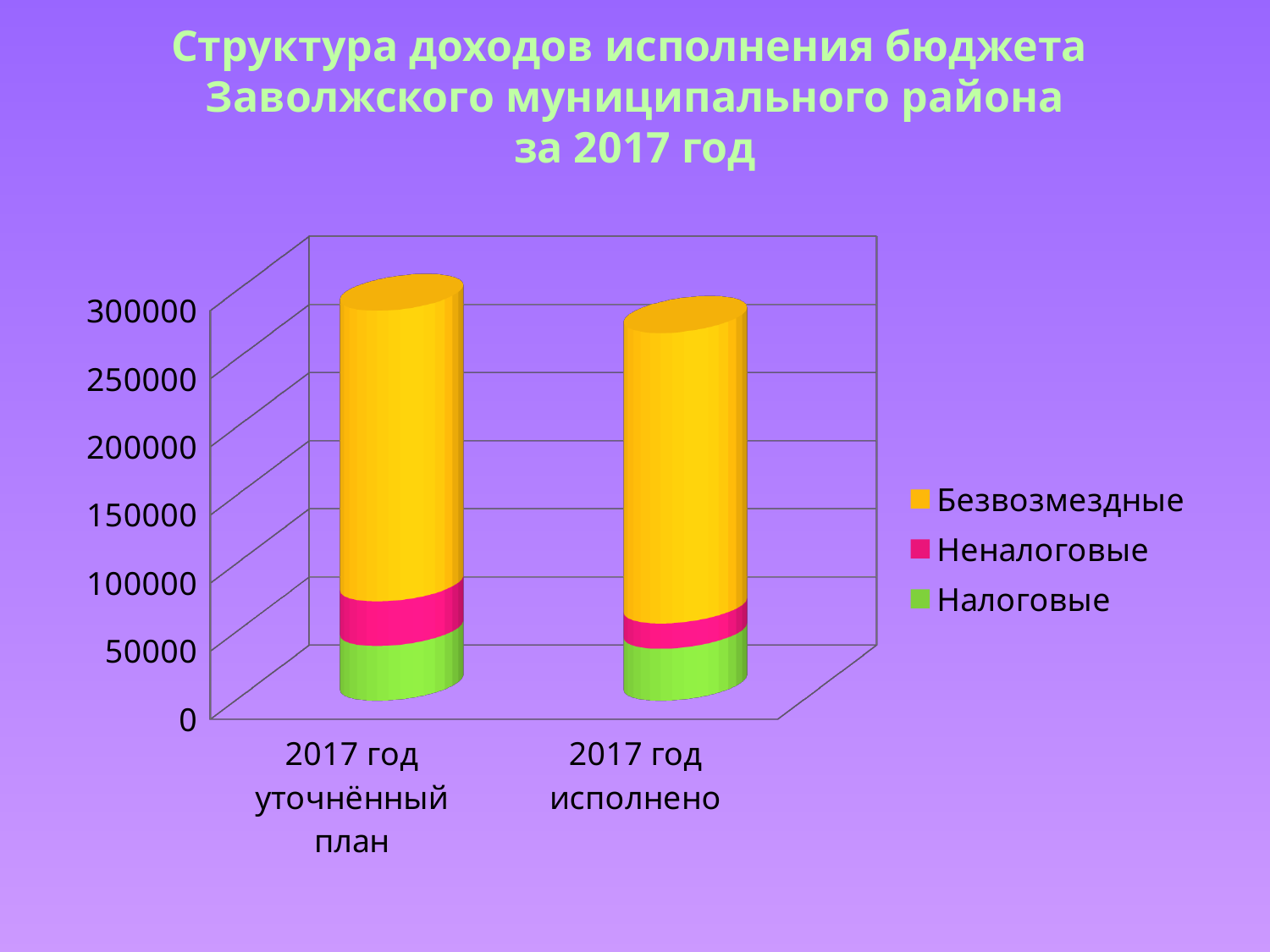
Does the total bar height rise or fall from '2017 год уточнённый план' to '2017 год исполнено'? fall Is the total value of the bar for '2017 год уточнённый план' greater or less than 200000? greater How many series does the legend list? 3 What kind of chart is shown on the slide? Stacked bar chart Which series makes up the largest part of the bar for '2017 год исполнено'? Безвозмездные Is the total value of the bar for '2017 год исполнено' greater or less than 200000? greater How many categories are shown on the x axis of the chart? 2 Is the value of 'Неналоговые' larger for '2017 год уточнённый план' or for '2017 год исполнено'? 2017 год уточнённый план Which series makes up the smallest part of the bar for '2017 год исполнено'? Неналоговые Which series is shown in yellow in the chart? Безвозмездные Which category has the higher total bar, '2017 год уточнённый план' or '2017 год исполнено'? 2017 год уточнённый план Which series is shown in green in the chart? Налоговые